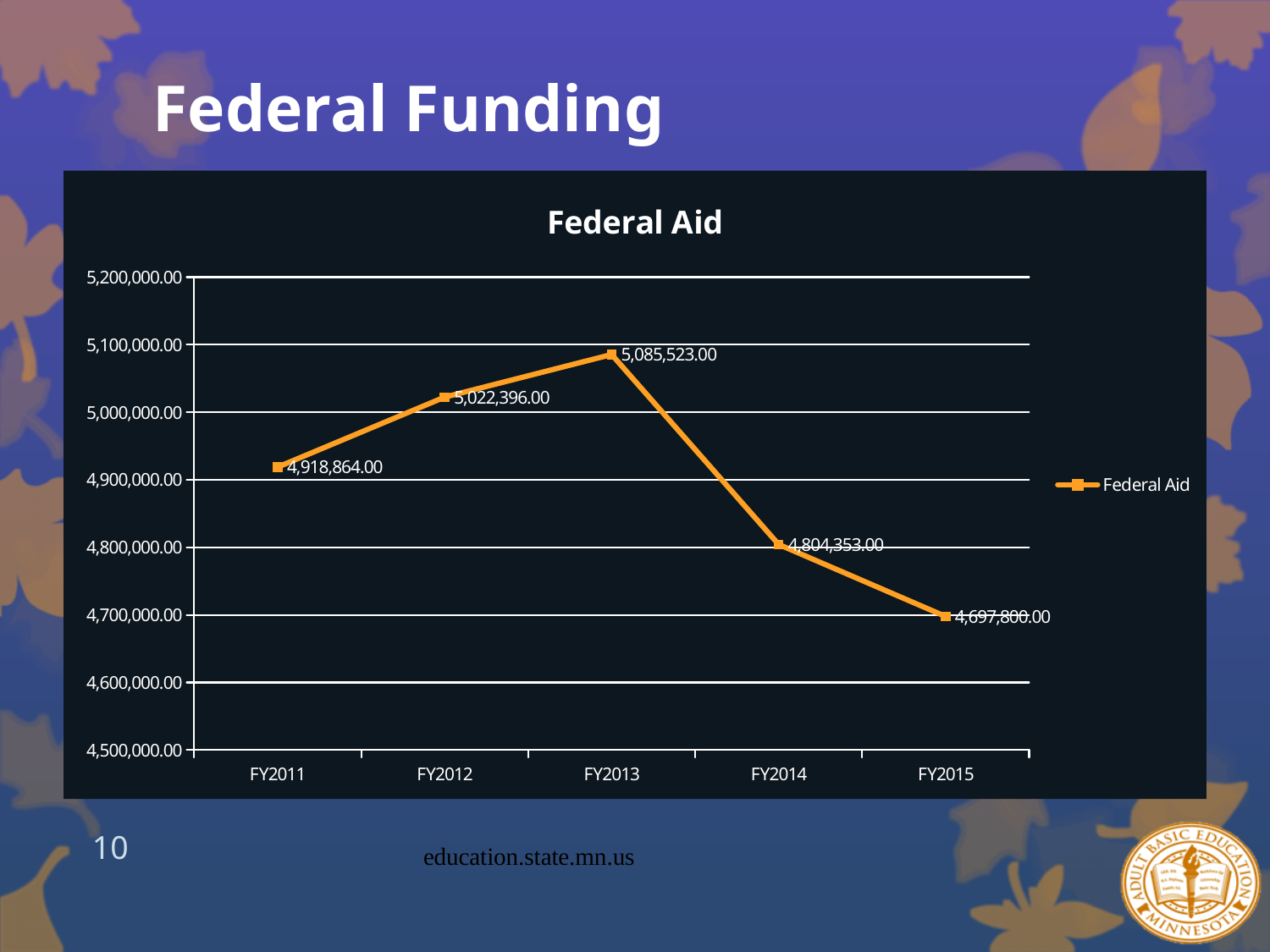
What kind of chart is shown on the slide? Line chart How many fiscal years are plotted on the chart? 5 Which is larger, the Federal Aid value for FY2012 or for FY2014? FY2012 What is the Federal Aid value for FY2014? 4,804,353.00 What is the difference between the Federal Aid values for FY2011 and FY2015? 221,064.00 What is the Federal Aid value for FY2015? 4,697,800.00 What is the Federal Aid value for FY2011? 4,918,864.00 Does the Federal Aid value rise or fall from FY2013 to FY2015? Fall What is the Federal Aid value for FY2013? 5,085,523.00 Which fiscal year has the highest Federal Aid value? FY2013 Which fiscal year has the lowest Federal Aid value? FY2015 What is the difference between the Federal Aid values for FY2013 and FY2012? 63,127.00